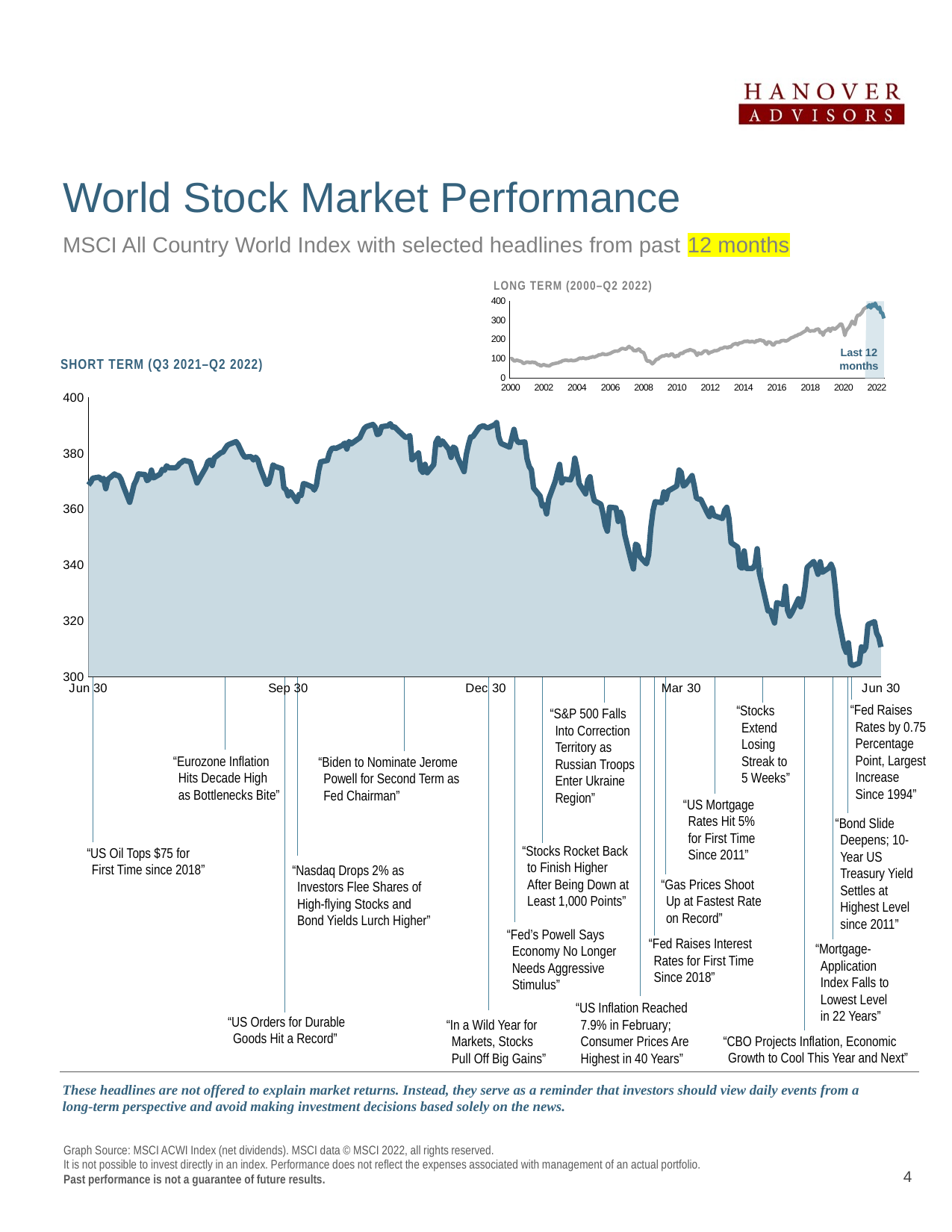
On the SHORT TERM chart, is the highest point of the line greater or less than 380? greater What label is given to the shaded region at the right end of the LONG TERM chart? Last 12 months On the LONG TERM (2000–Q2 2022) chart, does the index overall rise or fall from 2000 to 2022? rise What kind of chart is the SHORT TERM (Q3 2021–Q2 2022) chart? line chart with a shaded area beneath (area chart) On the LONG TERM chart, is the index value in 2002 greater or less than 100? less On the SHORT TERM chart, is the index value at the starting Jun 30 greater or less than 360? greater On the SHORT TERM chart, does the index overall rise or fall from the first Jun 30 to the last Jun 30? fall What is the lowest value shown on the y axis of the SHORT TERM chart? 300 How many date labels are shown on the x axis of the SHORT TERM chart? 5